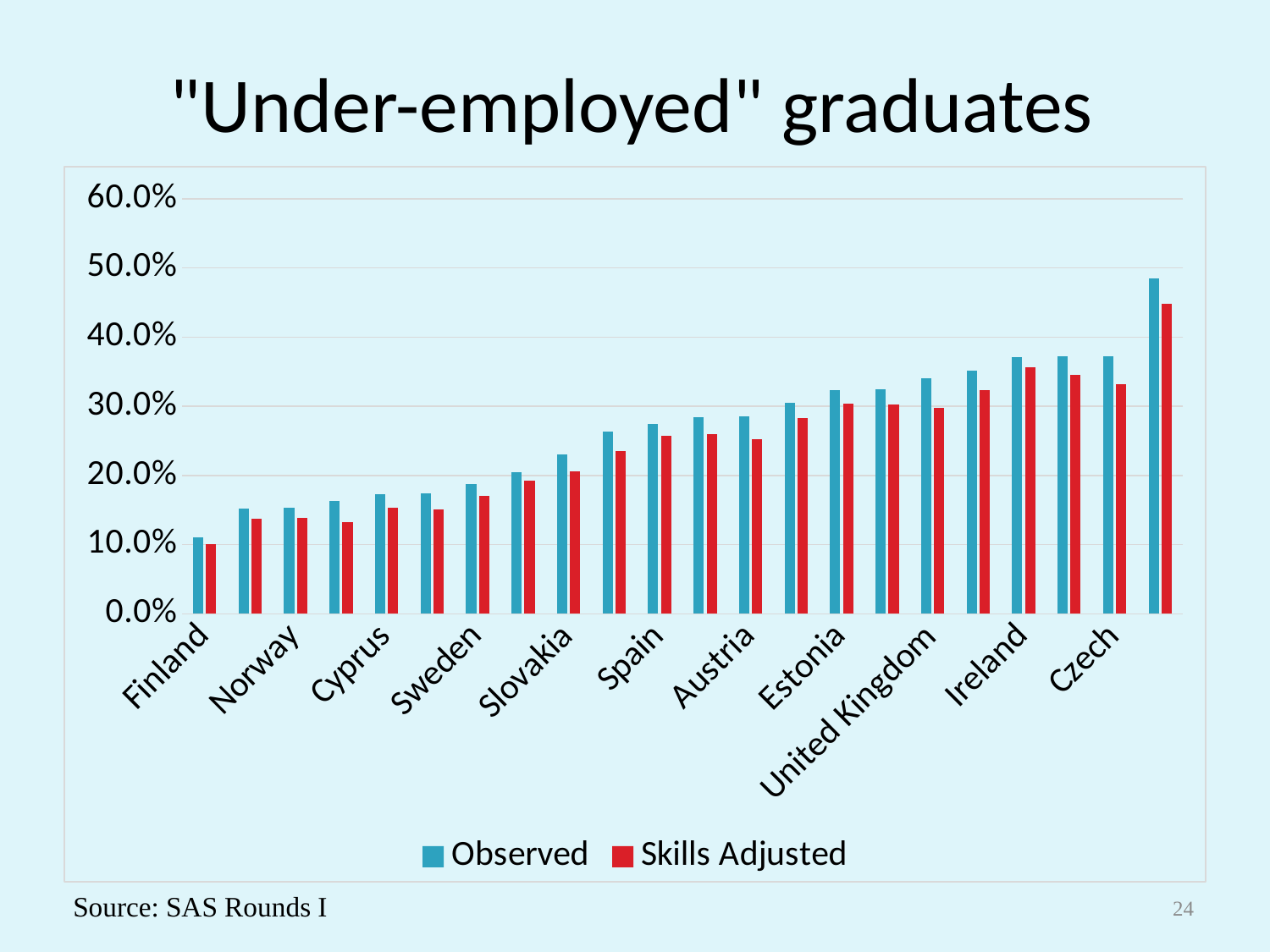
Is the Observed value for Finland greater or less than 20.0%? less Which country has the larger Observed value, Finland or Ireland? Ireland Which is larger for Ireland, the Observed value or the Skills Adjusted value? Observed Which labelled country has the lowest Observed value? Finland How many series does the legend list? 2 Is the Observed value for Czech greater or less than 30.0%? greater Do the Observed values generally rise or fall from left to right across the countries? rise Is the Observed value for Slovakia greater or less than 20.0%? greater What kind of chart is shown on the slide? bar chart What are the two series named in the legend? Observed and Skills Adjusted